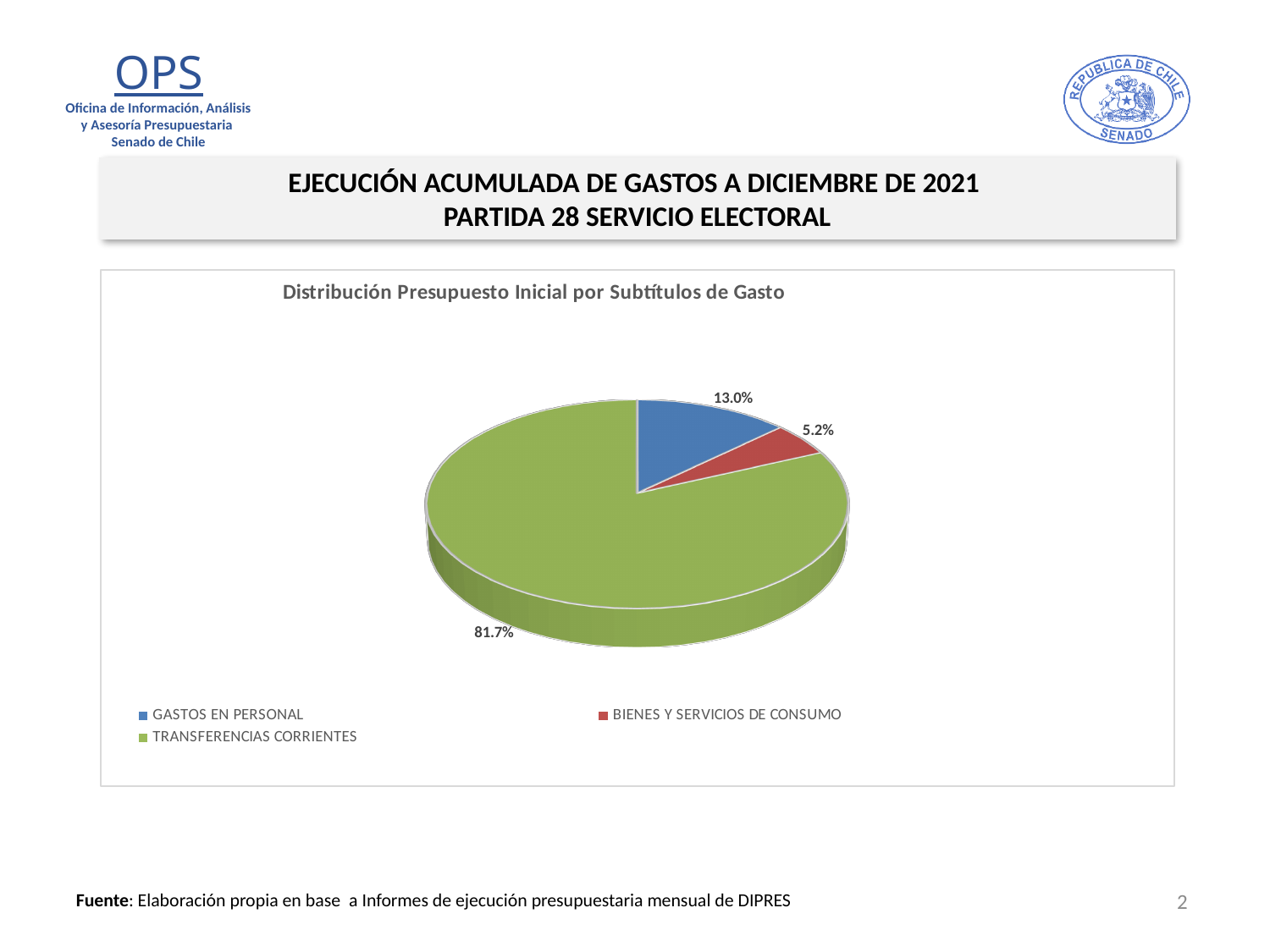
Which category has the smallest slice of the pie? BIENES Y SERVICIOS DE CONSUMO What is the title of the chart? Distribución Presupuesto Inicial por Subtítulos de Gasto How many categories does the pie chart show? 3 Which is larger, the share for GASTOS EN PERSONAL or the share for BIENES Y SERVICIOS DE CONSUMO? GASTOS EN PERSONAL What colour is the slice for TRANSFERENCIAS CORRIENTES? Green What share of the pie does BIENES Y SERVICIOS DE CONSUMO represent? 5.2% What share of the pie does GASTOS EN PERSONAL represent? 13.0% Which category has the largest slice of the pie? TRANSFERENCIAS CORRIENTES What is the difference in percentage points between GASTOS EN PERSONAL and BIENES Y SERVICIOS DE CONSUMO? 7.8 percentage points What share of the pie does TRANSFERENCIAS CORRIENTES represent? 81.7% What type of chart is shown on the slide? Pie chart How many entries does the legend list? 3